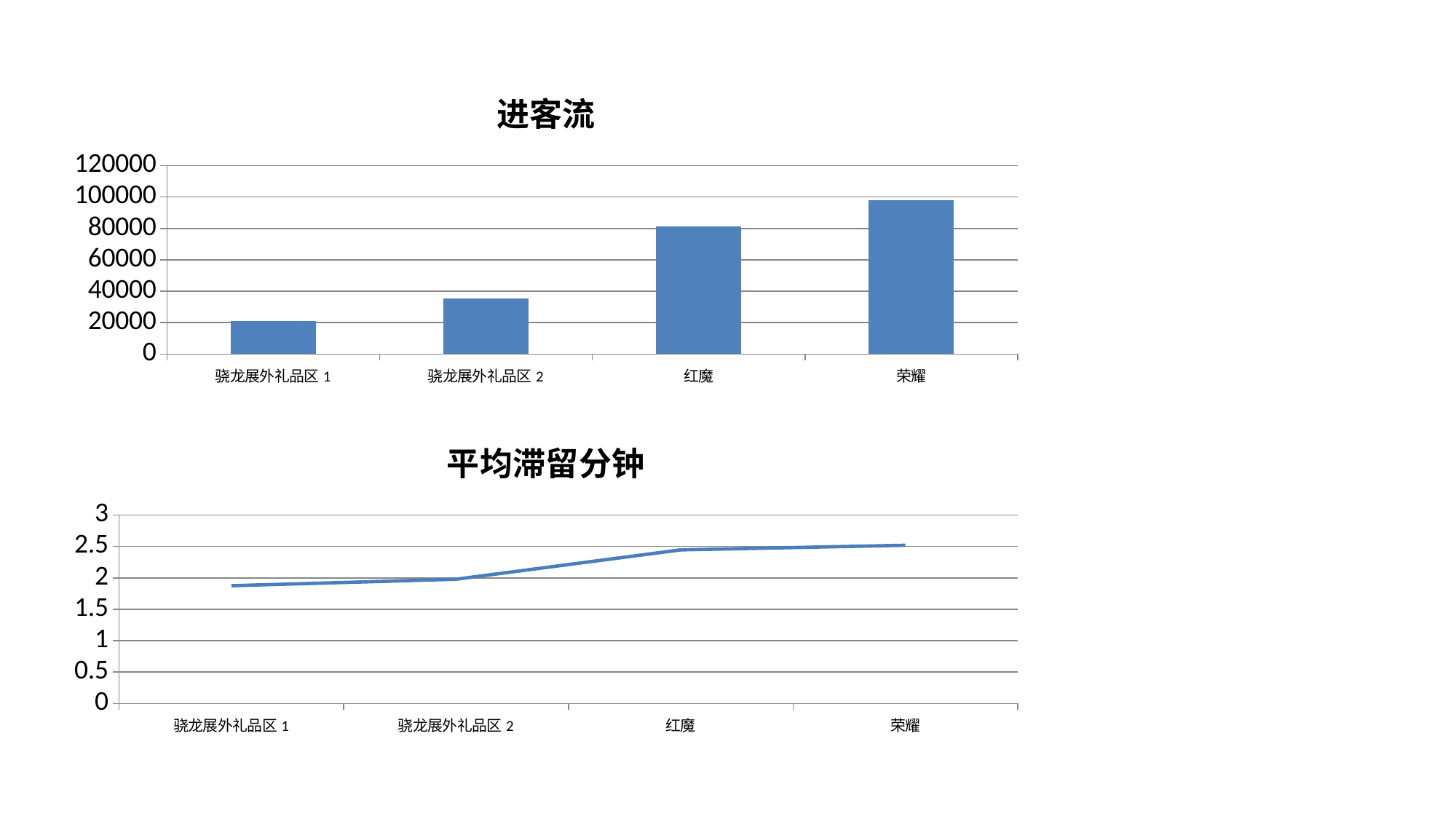
What is the title of the bottom chart on the slide? 平均滞留分钟 In the 进客流 chart, is the value for 红魔 greater or less than 60000? greater In the 进客流 chart, which is larger, the value for 骁龙展外礼品区 2 or the value for 红魔? 红魔 In the 平均滞留分钟 chart, do the values rise or fall from left to right along the x axis? rise In the 进客流 chart, how many categories are shown on the x axis? 4 In the 平均滞留分钟 chart, is the value for 骁龙展外礼品区 1 greater or less than 2? less What kind of chart is the bottom chart titled 平均滞留分钟? line chart What kind of chart is the top chart titled 进客流? bar chart In the 进客流 chart, which category has the highest value? 荣耀 In the 平均滞留分钟 chart, is the value for 红魔 greater or less than 2? greater In the 进客流 chart, which category has the lowest value? 骁龙展外礼品区 1